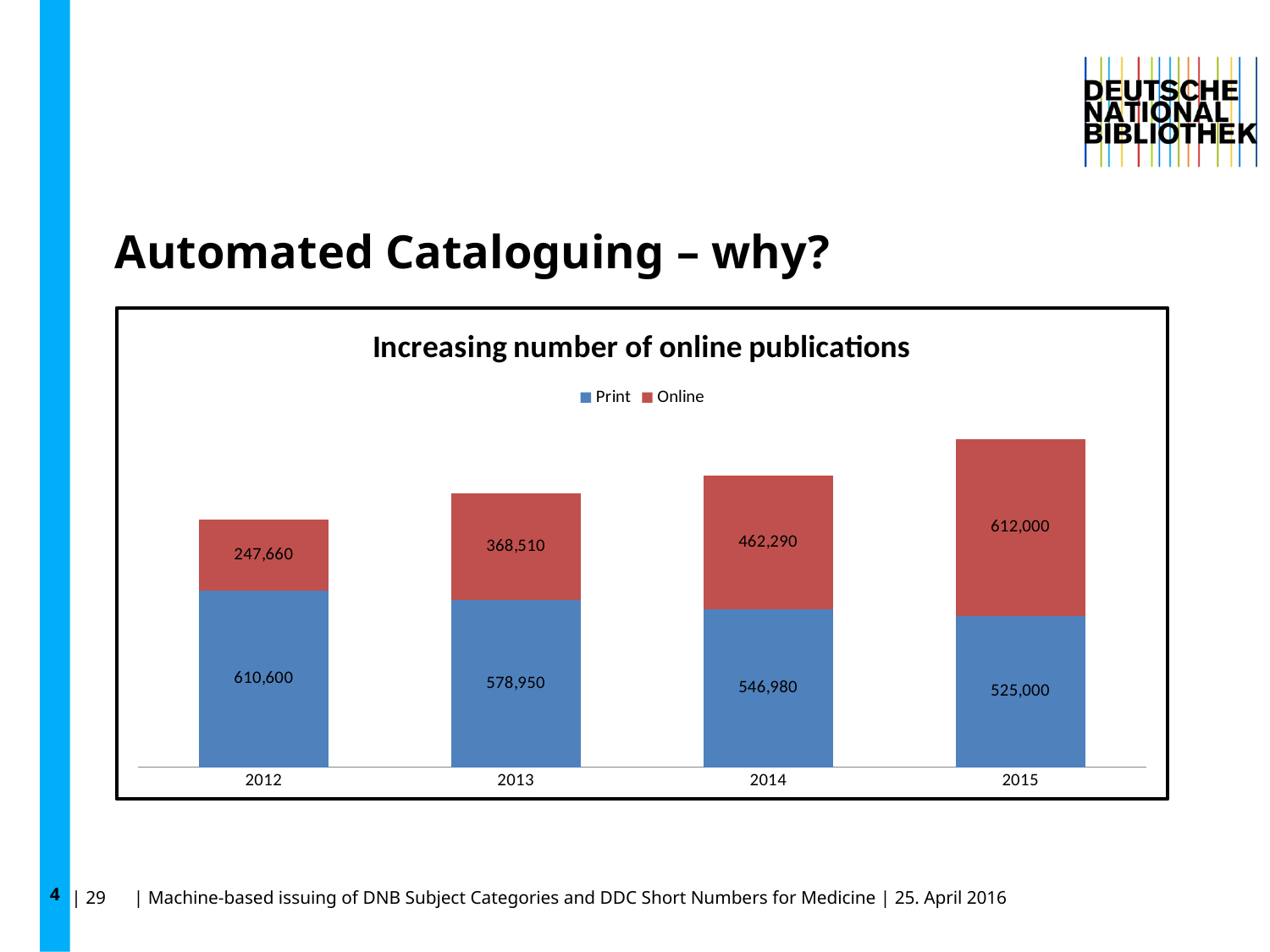
How many years are shown on the x axis? 4 What is the difference between the Print values for 2012 and 2015? 85,600 What is the Print value for 2012? 610,600 How many series does the legend list? 2 What is the Online value for 2013? 368,510 What is the Online value for 2015? 612,000 What is the total of the stacked bar for 2014? 1,009,270 Which year has the lowest Print value? 2015 Do the Online values rise or fall from 2012 to 2015? Rise Which is larger in 2015, the Print value or the Online value? Online Which year has the highest Online value? 2015 What kind of chart is shown? Stacked bar chart